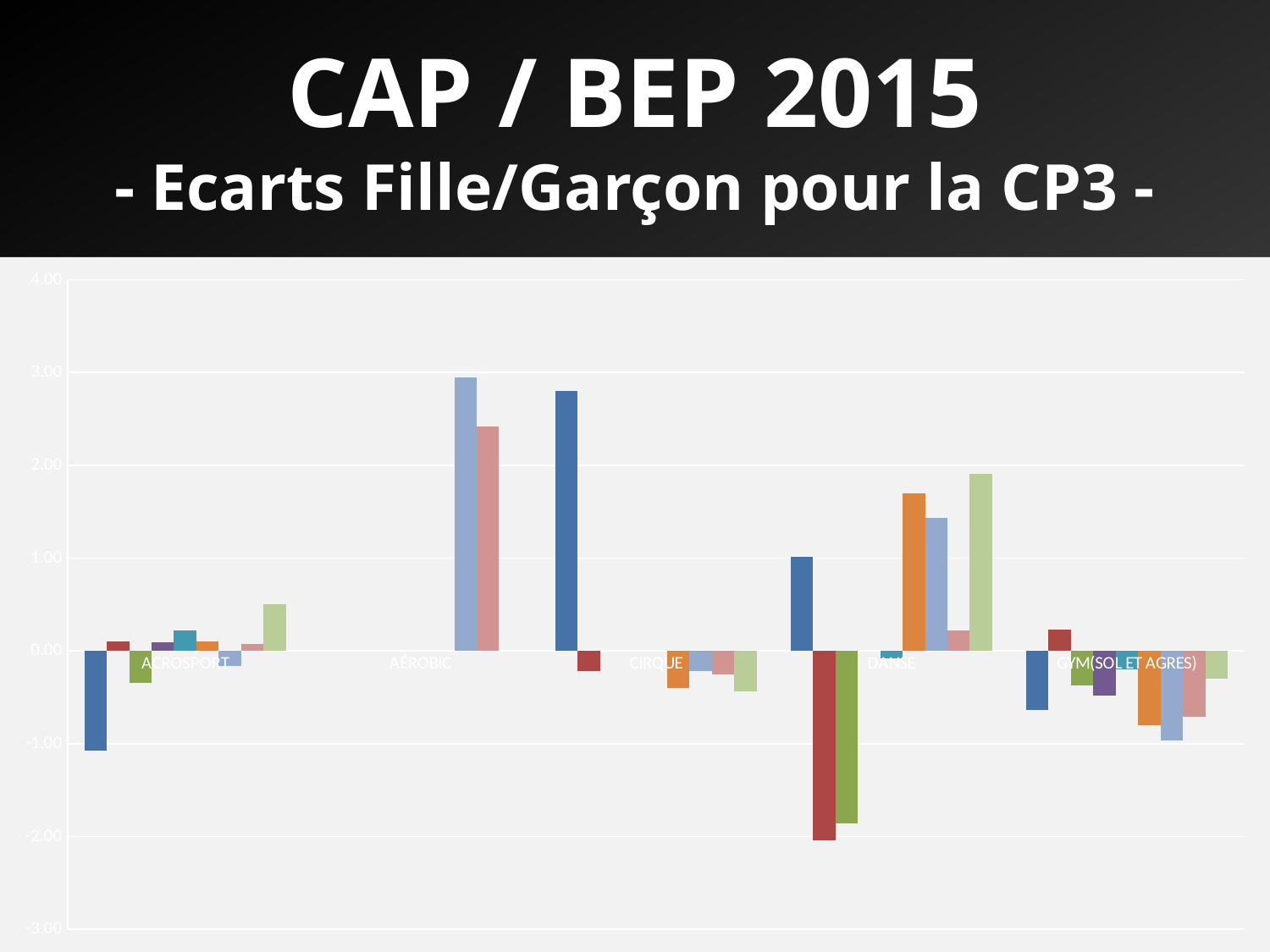
What kind of chart is shown on the slide? bar chart Is the tallest bar in the AÉROBIC category greater or less than 2.00? greater Which category contains the lowest (most negative) bar on the chart? DANSE Which category has a taller maximum bar, AÉROBIC or GYM(SOL ET AGRES)? AÉROBIC What is the highest value shown on the vertical axis of the chart? 4.00 How many categories are shown on the x axis of the chart? 5 What is the title of the slide containing the chart? CAP / BEP 2015 - Ecarts Fille/Garçon pour la CP3 - Is the tallest bar in the ACROSPORT category greater or less than 1.00? less Is the lowest bar in the DANSE category greater or less than -1.00? less Which category contains the tallest bar on the chart? AÉROBIC